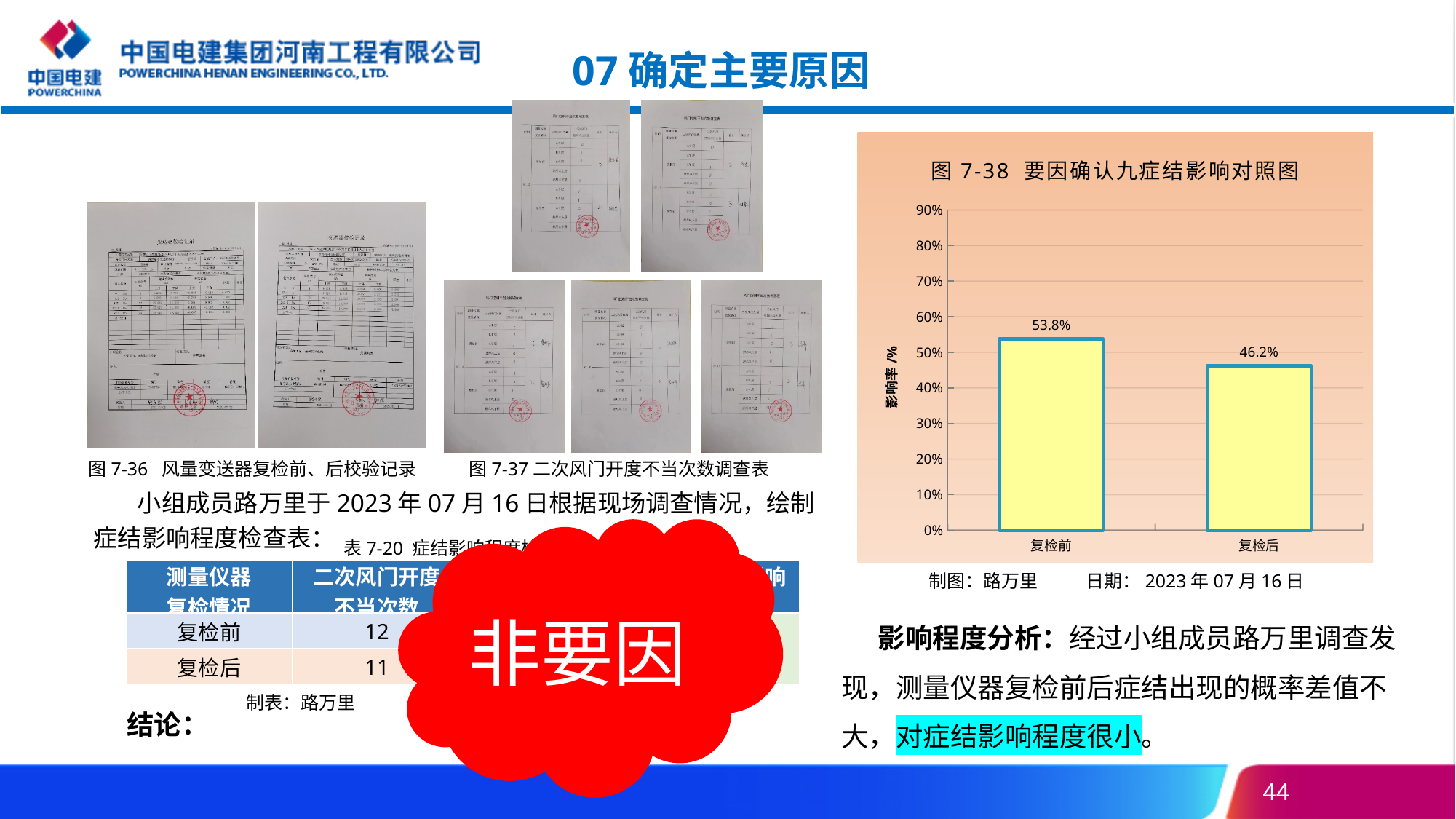
Is the value for 复检前 greater or less than 50%? greater Which category has the lowest value in the chart? 复检后 What is the label of the y axis of the chart? 影响率 /% What is the value for 复检后 in the chart? 46.2% Which category has the highest value in the chart? 复检前 How many categories are shown in the chart? 2 What is the value for 复检前 in the chart? 53.8% What is the title of the chart? 图 7-38 要因确认九症结影响对照图 What is the difference between the values for 复检前 and 复检后? 7.6% Is the value for 复检后 greater or less than 50%? less Which is larger, the value for 复检前 or the value for 复检后? 复检前 What kind of chart is shown on the slide? bar chart